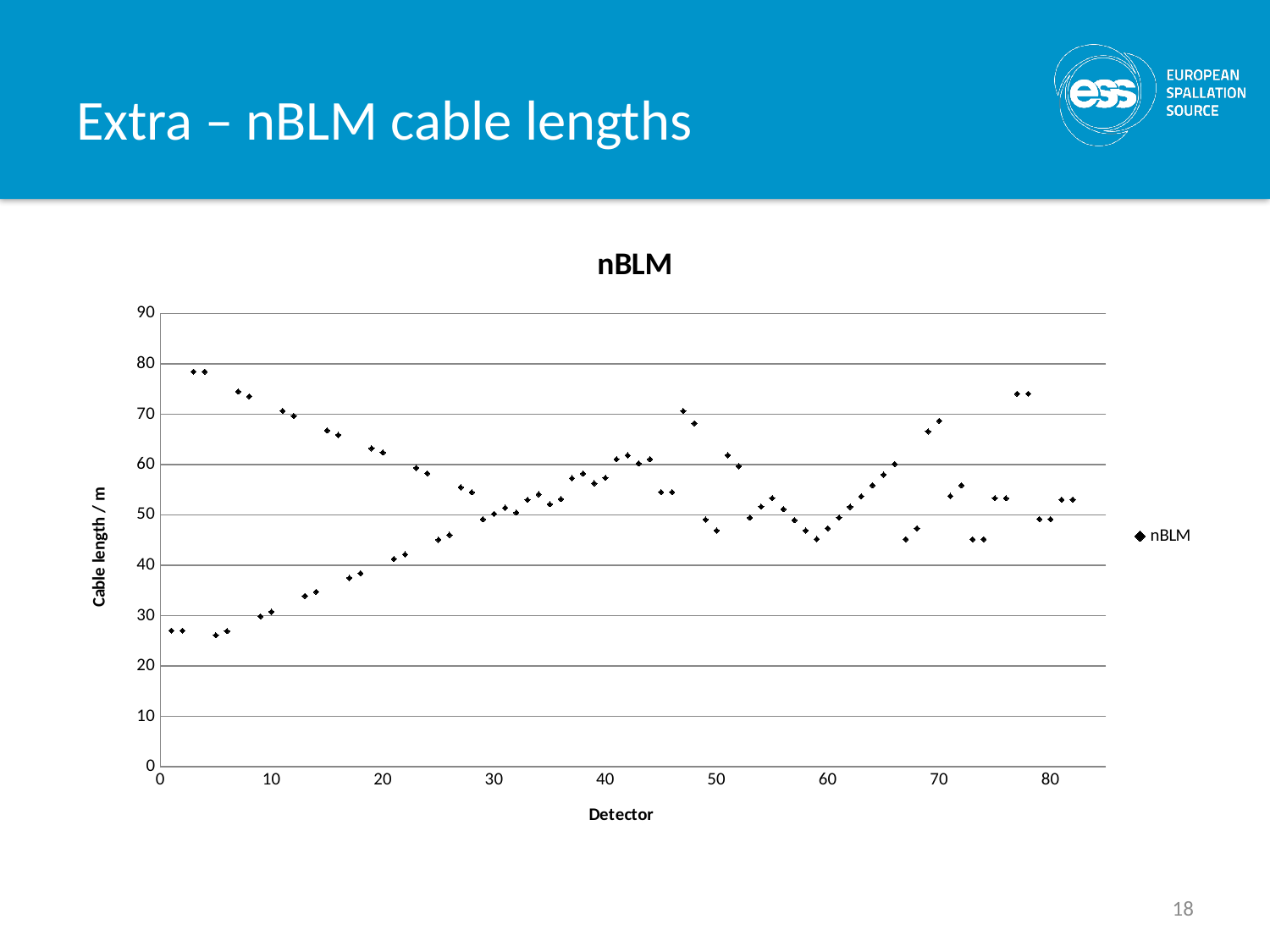
Is the lowest cable length plotted on the chart greater or less than 30? less What is the label of the vertical axis of the chart? Cable length / m Is the cable length for the points near detector 77 and 78 greater or less than 70? greater Is the cable length for the point near detector 20 greater or less than 60? greater What kind of chart is shown on the slide? scatter chart What is the title of the chart? nBLM What is the highest value shown on the vertical axis of the chart? 90 How many series does the legend list? 1 Do the points that start near 78 m at detector 3 rise or fall as the detector number increases toward 20? fall